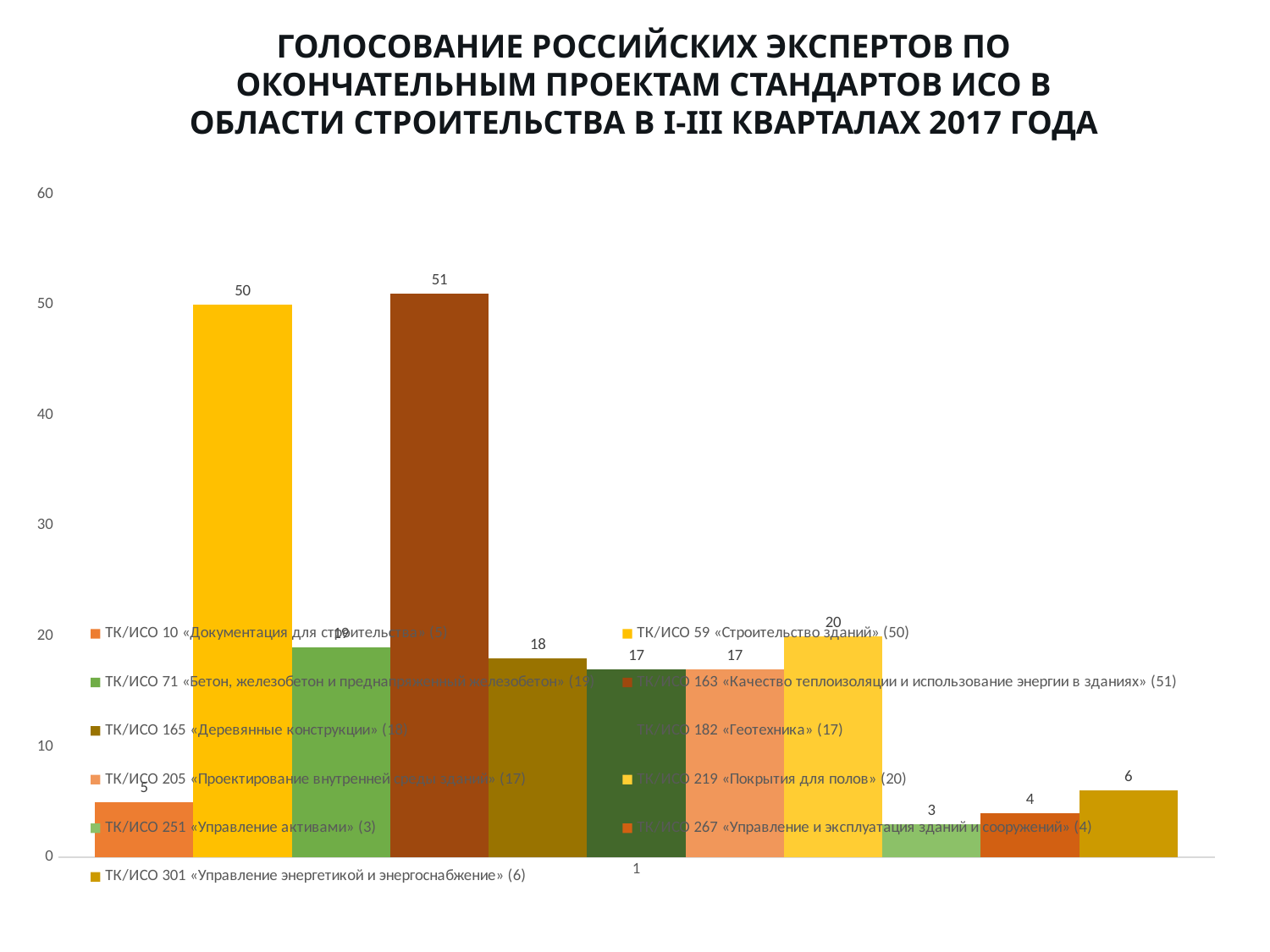
What is the difference between the values for ТК/ИСО 163 and ТК/ИСО 59? 1 Is the value for ТК/ИСО 59 «Строительство зданий» greater or less than 40? greater What kind of chart is shown on the slide? bar chart What is the title of the chart? ГОЛОСОВАНИЕ РОССИЙСКИХ ЭКСПЕРТОВ ПО ОКОНЧАТЕЛЬНЫМ ПРОЕКТАМ СТАНДАРТОВ ИСО В ОБЛАСТИ СТРОИТЕЛЬСТВА В I-III КВАРТАЛАХ 2017 ГОДА What value is shown for ТК/ИСО 163 «Качество теплоизоляции и использование энергии в зданиях»? 51 What is the difference between the values for ТК/ИСО 219 «Покрытия для полов» and ТК/ИСО 165 «Деревянные конструкции»? 2 What value is shown for ТК/ИСО 301 «Управление энергетикой и энергоснабжение»? 6 What value is shown for ТК/ИСО 59 «Строительство зданий»? 50 What value is shown for ТК/ИСО 10 «Документация для строительства»? 5 Which has a larger value: ТК/ИСО 71 «Бетон, железобетон и преднапряженный железобетон» or ТК/ИСО 165 «Деревянные конструкции»? ТК/ИСО 71 «Бетон, железобетон и преднапряженный железобетон» Which technical committee has the highest value in the chart? ТК/ИСО 163 «Качество теплоизоляции и использование энергии в зданиях» How many entries does the legend list? 11